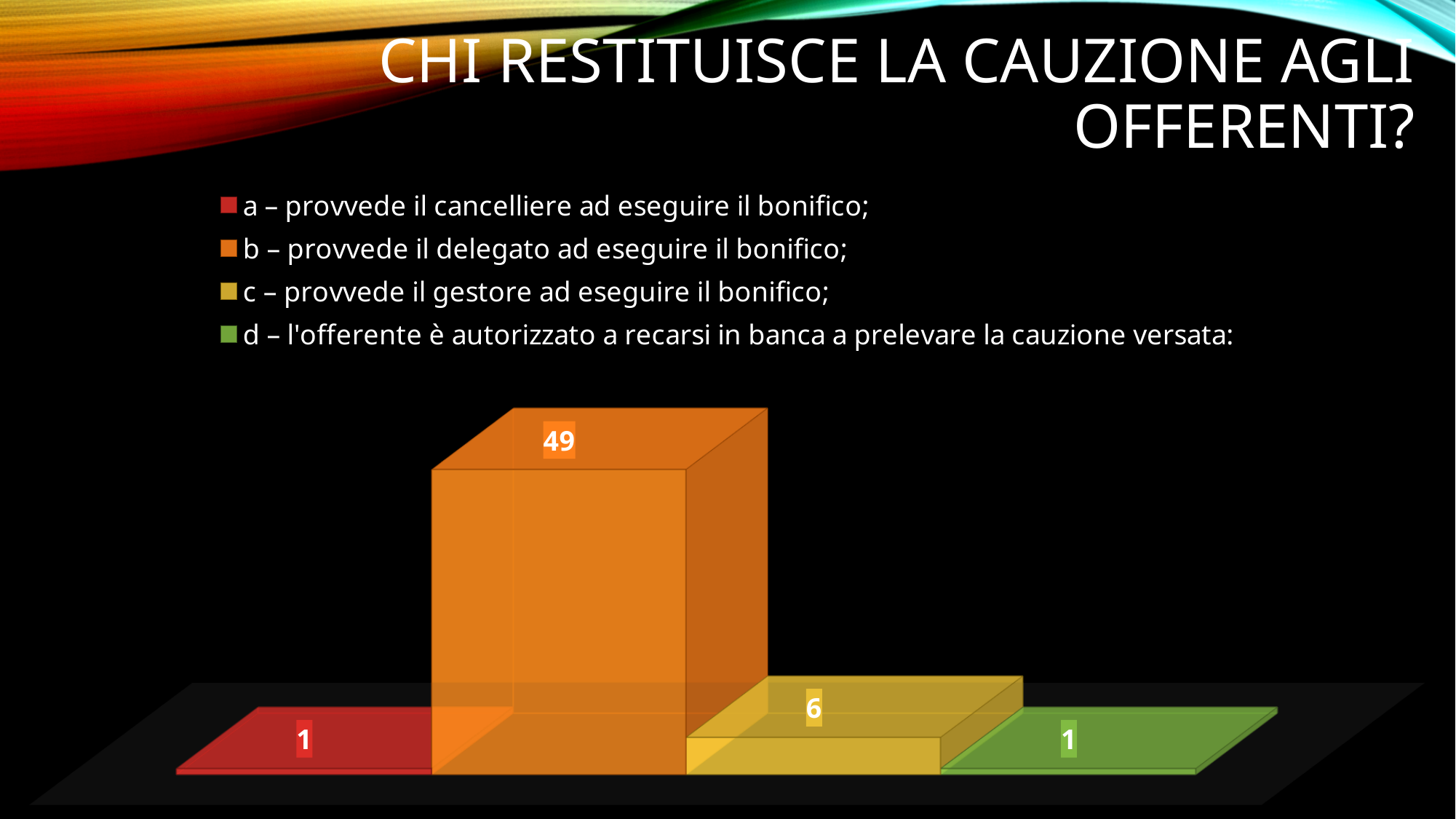
Which option has the highest value? b – provvede il delegato ad eseguire il bonifico Which is larger, the value for option c or the value for option d? option c What is the value for option b (provvede il delegato ad eseguire il bonifico)? 49 What is the total of all the values shown in the chart? 57 What colour is the bar for option b? orange What is the value for option c (provvede il gestore ad eseguire il bonifico)? 6 What is the value for option d (l'offerente è autorizzato a recarsi in banca)? 1 How many options (bars) are shown in the chart? 4 What kind of chart is shown on the slide? bar chart What is the difference between the values for option b and option c? 43 How many entries does the legend list? 4 What is the value for option a (provvede il cancelliere ad eseguire il bonifico)? 1